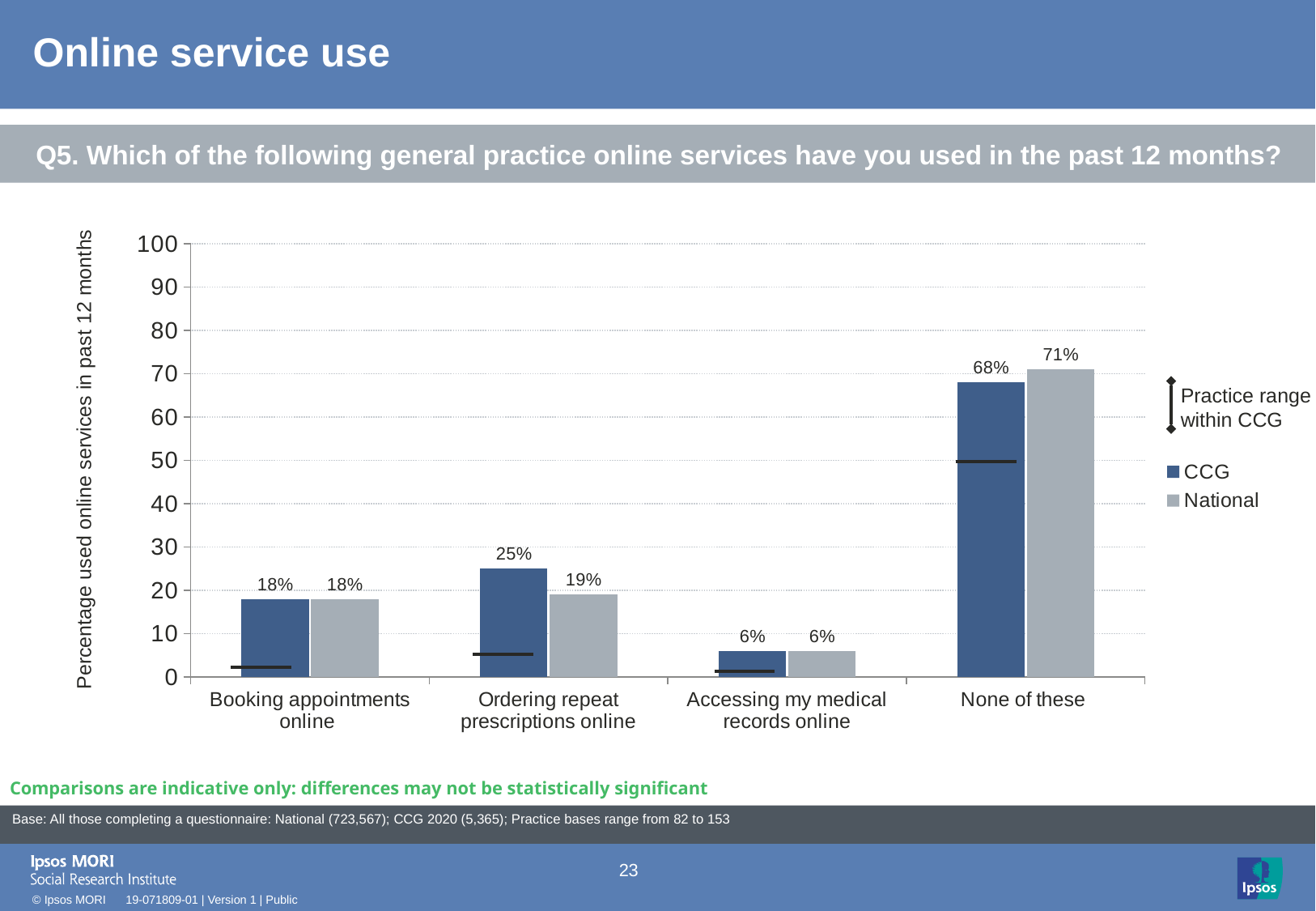
Which category has the highest CCG value? None of these What is the difference between the National and CCG values for None of these? 3% What does the black line marker in the legend represent? Practice range within CCG How many series does the legend list as bars? 2 What is the National value for Accessing my medical records online? 6% What is the CCG value for None of these? 68% Which category has the lowest National value? Accessing my medical records online For Ordering repeat prescriptions online, which is larger: the CCG value or the National value? CCG What is the National value for Ordering repeat prescriptions online? 19% What is the CCG value for Booking appointments online? 18% What kind of chart is shown on the slide? Bar chart How many categories are shown on the x axis? 4